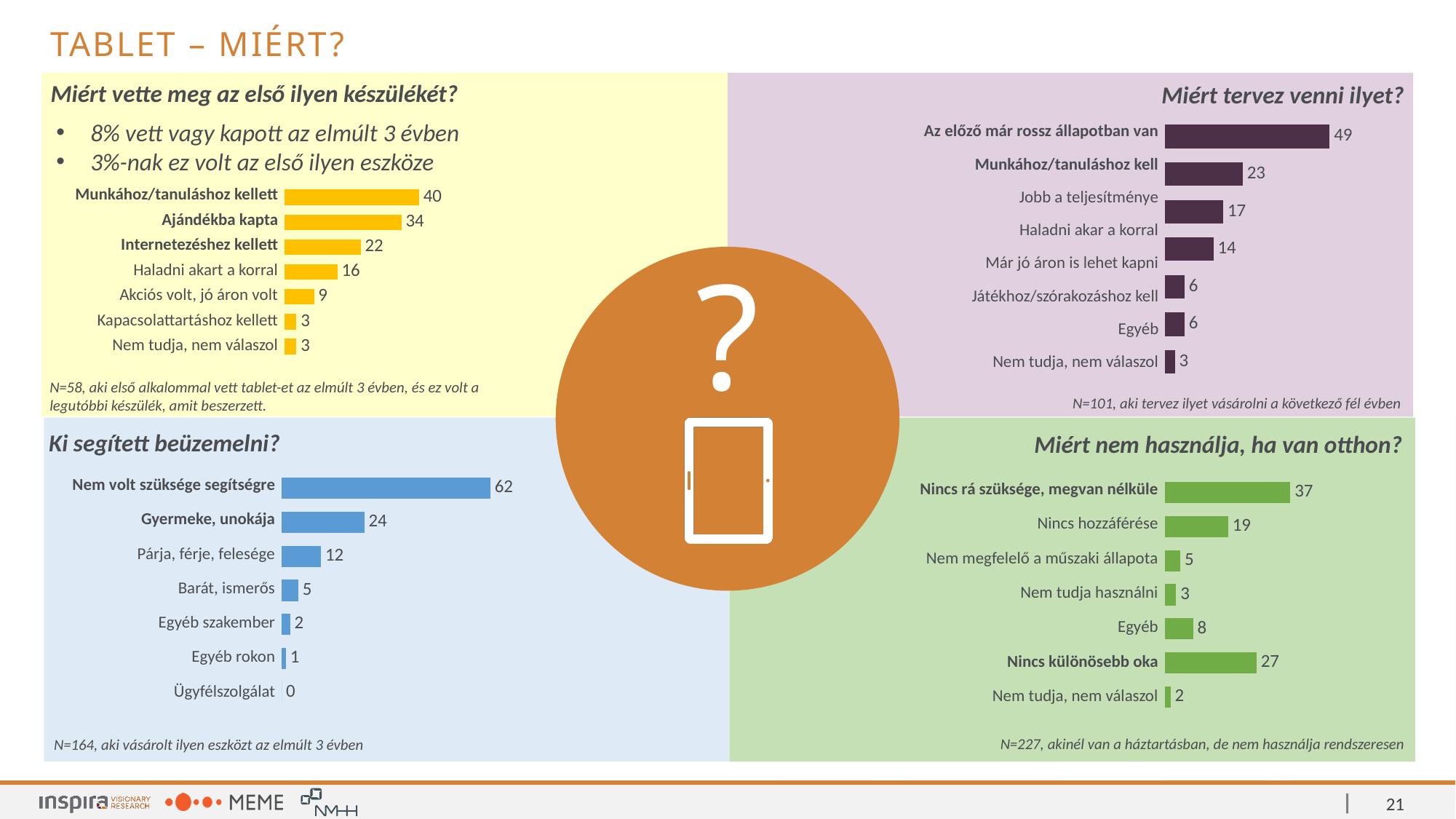
In the chart titled "Miért vette meg az első ilyen készülékét?", what is the value for "Ajándékba kapta"? 34 In the chart titled "Miért nem használja, ha van otthon?", what is the value for "Nincs különösebb oka"? 27 In the chart titled "Ki segített beüzemelni?", what kind of chart is it? bar chart In the chart titled "Miért tervez venni ilyet?", what is the value for "Jobb a teljesítménye"? 17 In the chart titled "Miért nem használja, ha van otthon?", how many categories are shown? 7 In the chart titled "Ki segített beüzemelni?", what is the value for "Párja, férje, felesége"? 12 In the chart titled "Miért vette meg az első ilyen készülékét?", how many categories are shown? 7 In the chart titled "Ki segített beüzemelni?", which category has the lowest value? Ügyfélszolgálat In the chart titled "Miért tervez venni ilyet?", what is the difference between "Az előző már rossz állapotban van" and "Munkához/tanuláshoz kell"? 26 In the chart titled "Miért nem használja, ha van otthon?", which is larger: "Nincs hozzáférése" or "Egyéb"? Nincs hozzáférése In the chart titled "Miért vette meg az első ilyen készülékét?", which category has the highest value? Munkához/tanuláshoz kellett